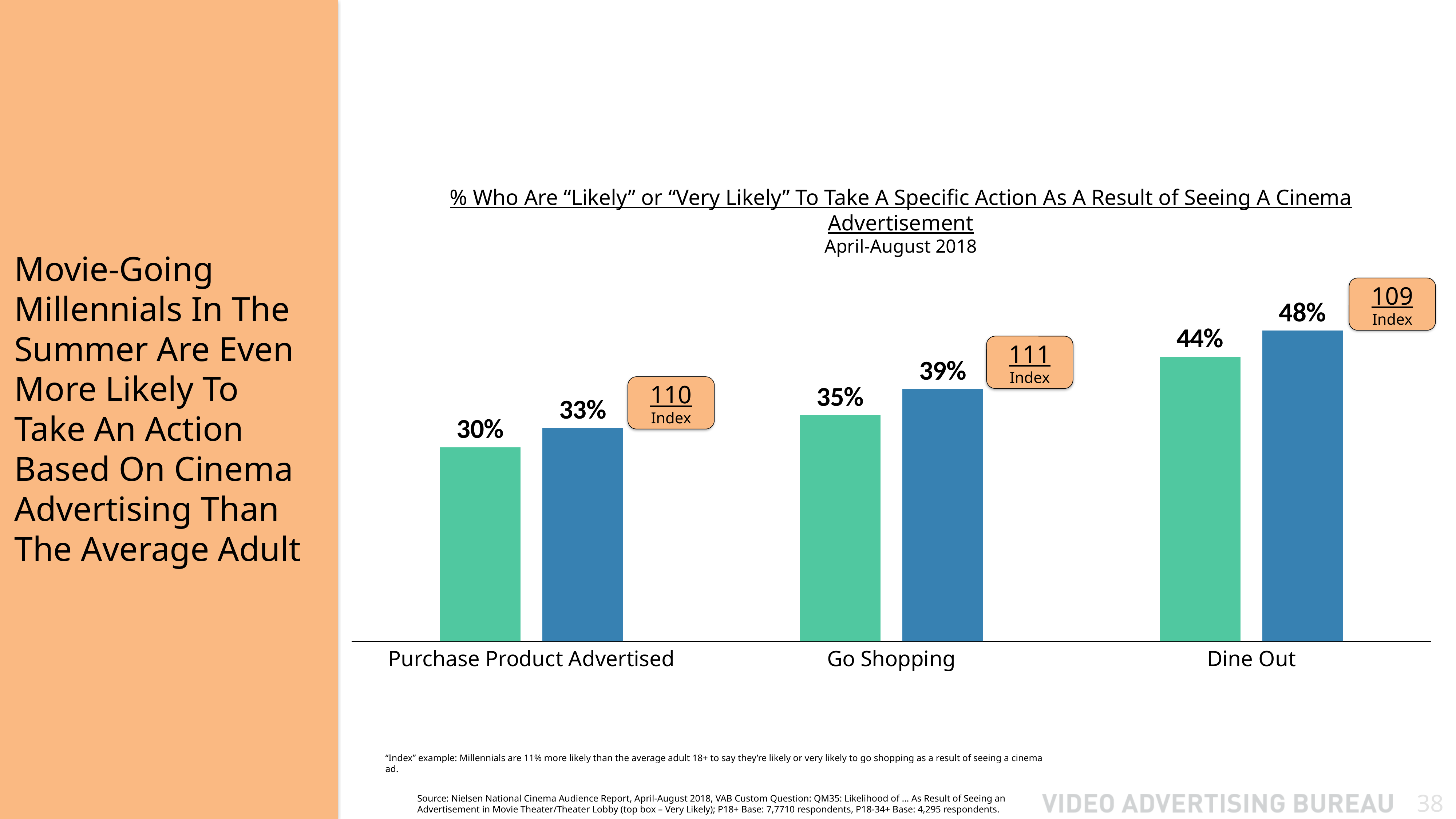
What is the difference between the blue bar and the green bar for Dine Out? 4% What kind of chart is shown on the slide? Bar chart What is the value of the blue bar for Dine Out? 48% What index value is shown for Purchase Product Advertised? 110 Do the bar values rise or fall from Purchase Product Advertised to Dine Out? Rise What is the value of the green bar for Purchase Product Advertised? 30% Which category has the lowest green bar value? Purchase Product Advertised What is the value of the green bar for Go Shopping? 35% Which is larger: the blue bar for Go Shopping or the blue bar for Purchase Product Advertised? Go Shopping How many categories are shown on the x axis? 3 Which category has the highest blue bar value? Dine Out Which category has the highest index value? Go Shopping